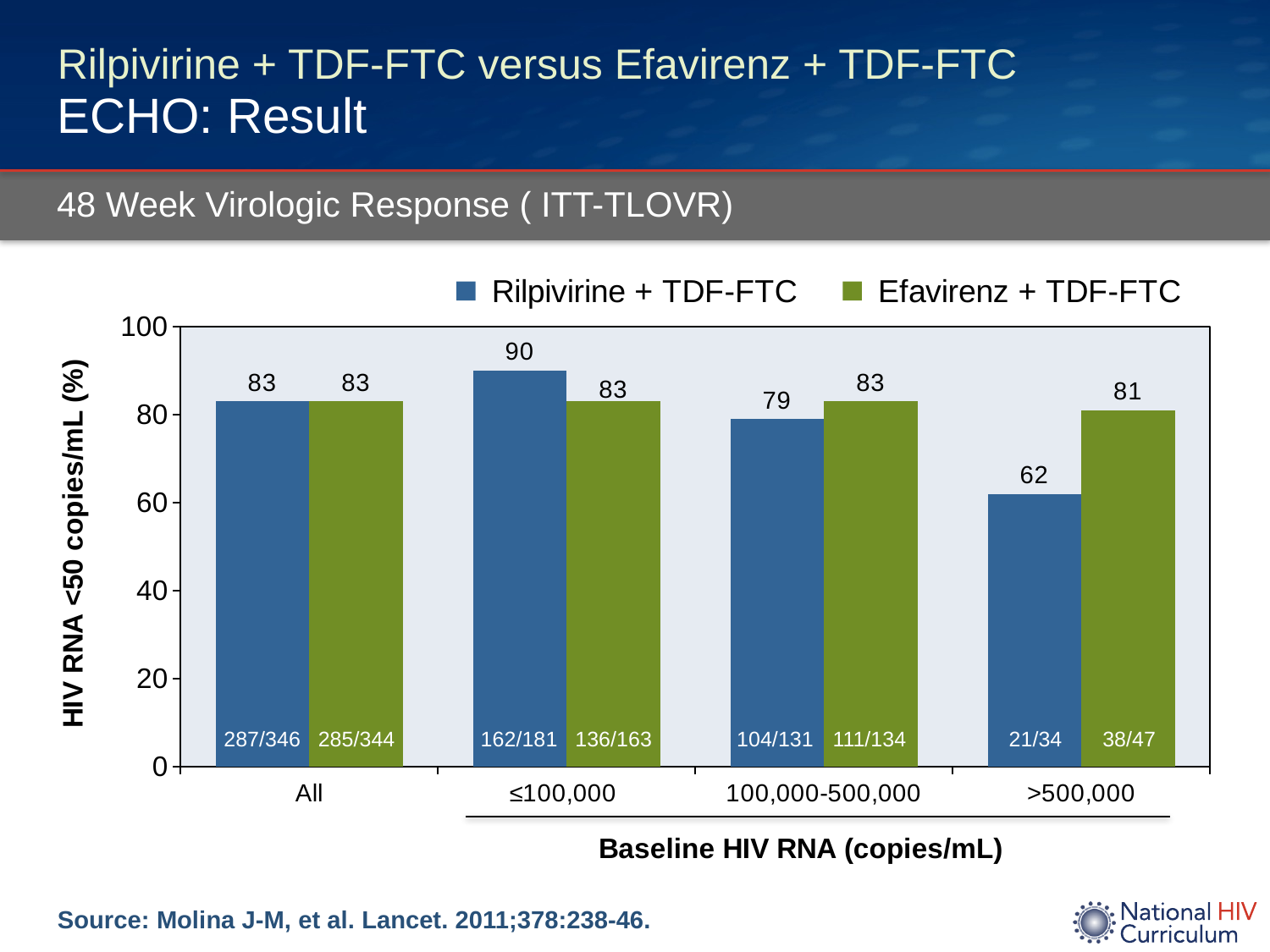
What kind of chart is shown on the slide? bar chart In the ≤100,000 category, which series has the larger value? Rilpivirine + TDF-FTC How many series does the legend list? 2 What is the difference between the Efavirenz + TDF-FTC and Rilpivirine + TDF-FTC values in the >500,000 category? 19 Is the value for Rilpivirine + TDF-FTC in the >500,000 category greater or less than 80? less What is the label of the y axis? HIV RNA <50 copies/mL (%) What is the value for Efavirenz + TDF-FTC in the >500,000 category? 81 Which category has the lowest value for Rilpivirine + TDF-FTC? >500,000 Which category has the highest value for Rilpivirine + TDF-FTC? ≤100,000 How many baseline HIV RNA categories are shown on the x axis? 4 What is the value for Rilpivirine + TDF-FTC in the ≤100,000 category? 90 What is the value for Rilpivirine + TDF-FTC in the 100,000-500,000 category? 79